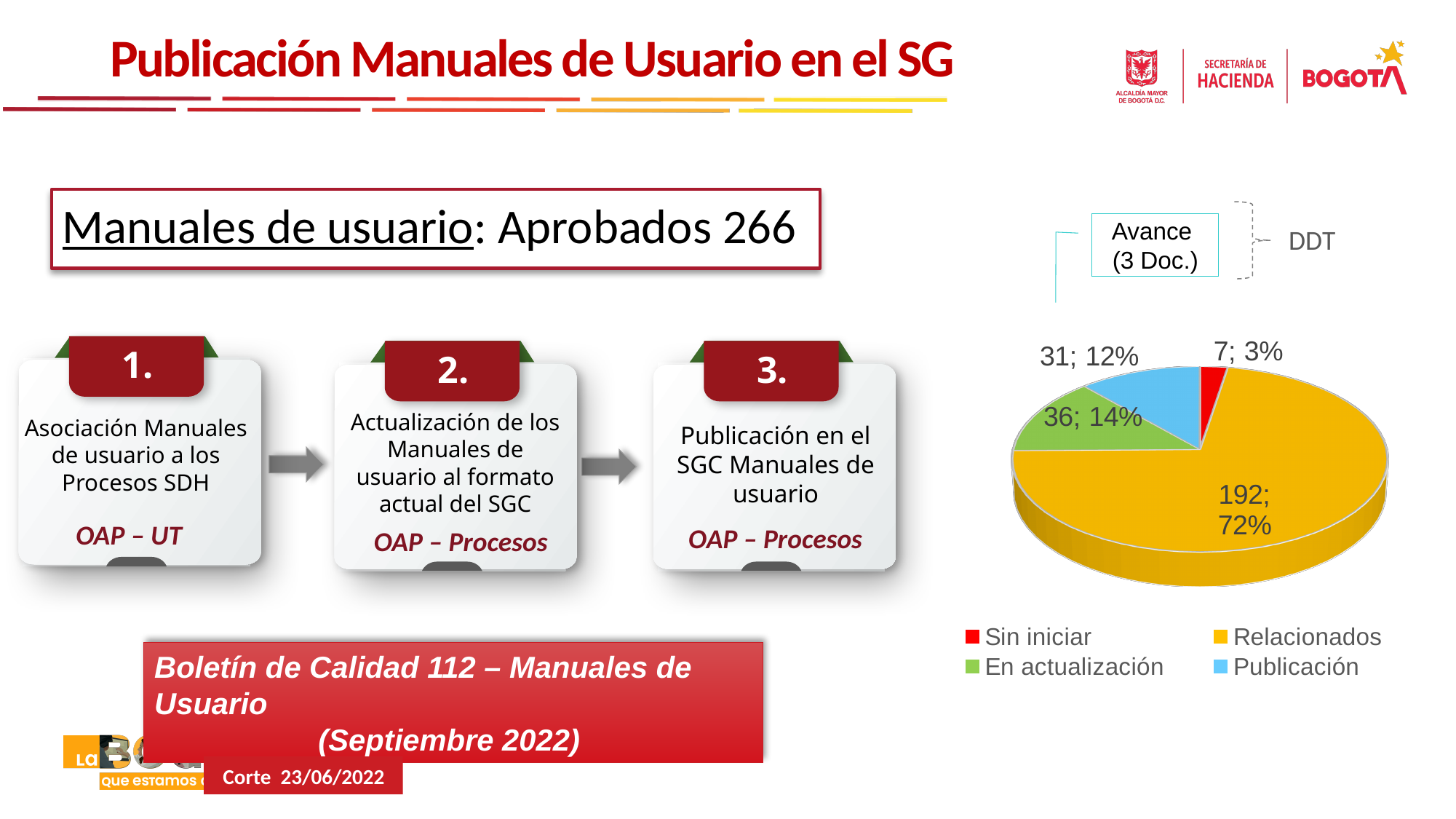
What is the value for Publicación in the pie chart? 31 What is the value for Relacionados in the pie chart? 192 How many slices does the pie chart have? 4 How many entries does the pie chart's legend list? 4 What kind of chart is shown on the slide? pie chart What is the value for Sin iniciar in the pie chart? 7 What share of the pie does Relacionados represent? 72% Which category has the smallest slice in the pie chart? Sin iniciar What is the value for En actualización in the pie chart? 36 Which category has the largest slice in the pie chart? Relacionados What is the difference between the values for En actualización and Publicación? 5 Which colour represents Publicación in the pie chart? blue